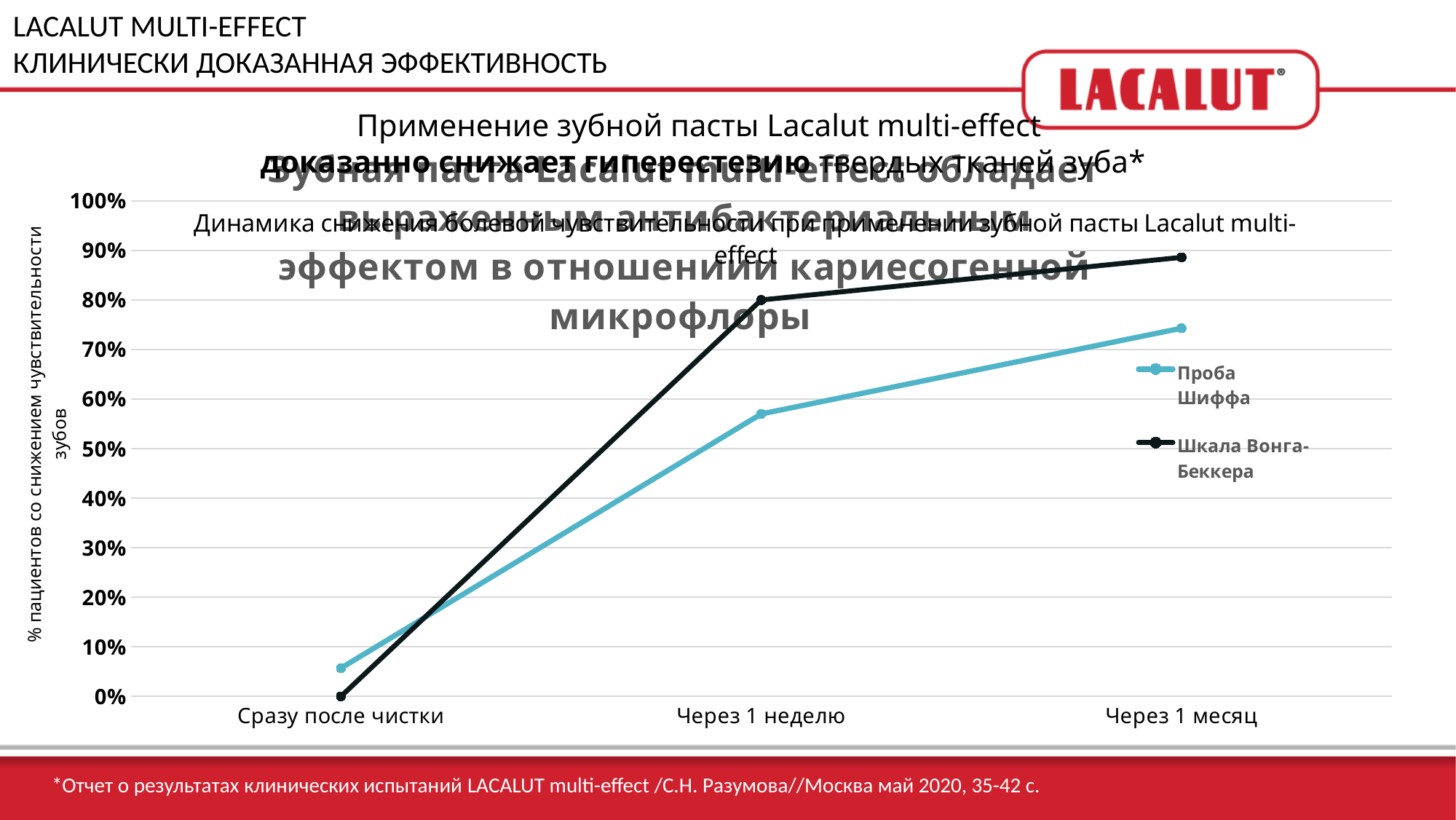
Is the value for Шкала Вонга-Беккера at Через 1 месяц greater or less than 80%? greater What is the value for Шкала Вонга-Беккера at Через 1 неделю? 80% Is the value for Проба Шиффа at Через 1 месяц greater or less than 70%? greater What kind of chart is shown on the slide? line chart What is the value for Шкала Вонга-Беккера at Сразу после чистки? 0% How many categories are shown on the x axis of the chart? 3 How many series does the chart legend list? 2 Is the value for Проба Шиффа at Через 1 неделю greater or less than 60%? less Which series has the higher value at Через 1 месяц, Проба Шиффа or Шкала Вонга-Беккера? Шкала Вонга-Беккера Do the values for Шкала Вонга-Беккера rise or fall from Сразу после чистки to Через 1 месяц? rise Which series is drawn in black on the chart? Шкала Вонга-Беккера